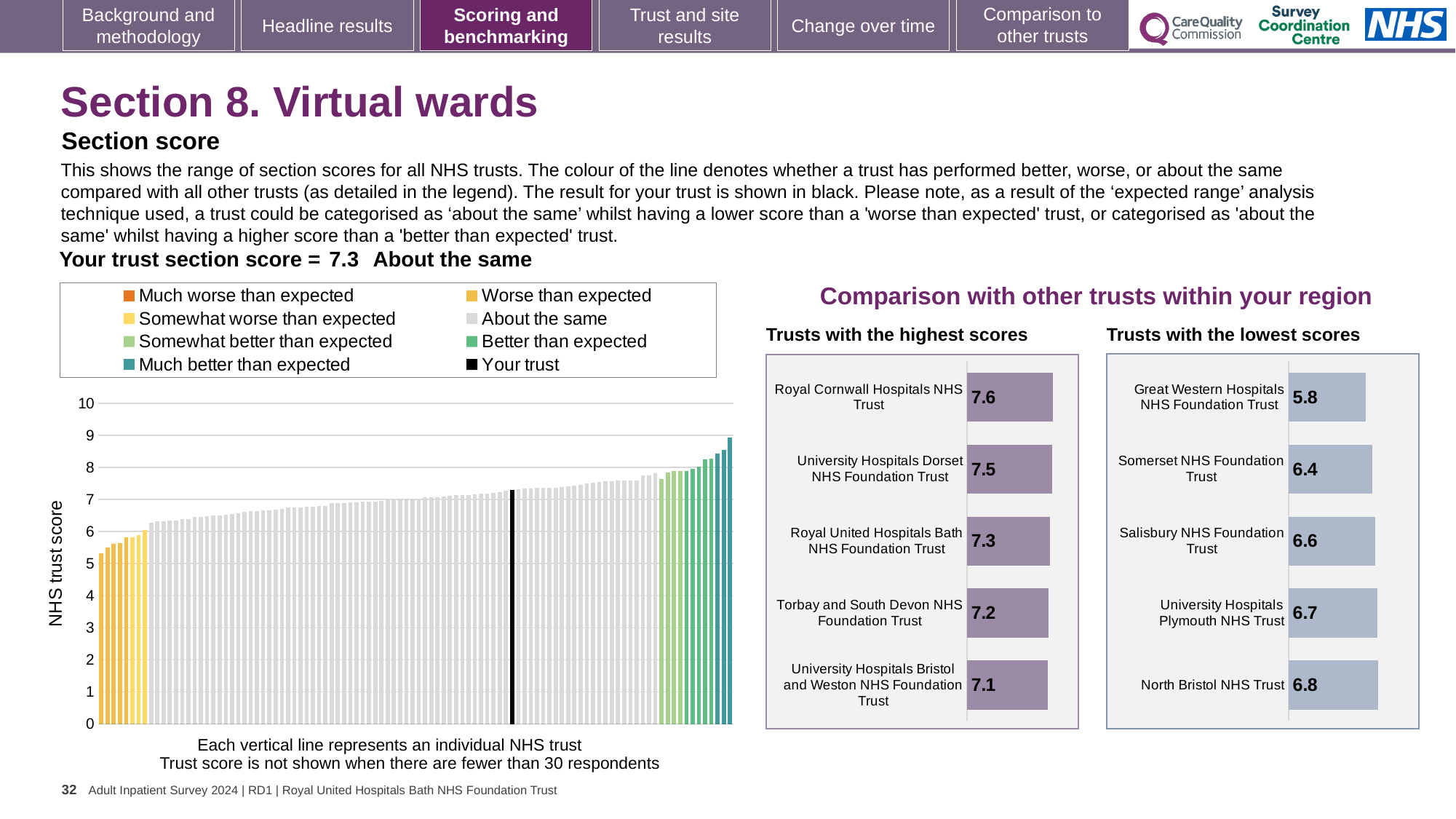
In the 'Trusts with the lowest scores' chart, what is the score for Somerset NHS Foundation Trust? 6.4 In the 'Trusts with the lowest scores' chart, how much higher is North Bristol NHS Trust's score than Great Western Hospitals NHS Foundation Trust's score? 1.0 In the 'Trusts with the highest scores' chart, which trust has the highest score? Royal Cornwall Hospitals NHS Trust In the 'Trusts with the highest scores' chart, what is the difference between the scores of Royal Cornwall Hospitals NHS Trust and University Hospitals Bristol and Weston NHS Foundation Trust? 0.5 In the 'Trusts with the lowest scores' chart, which trust has the lowest score? Great Western Hospitals NHS Foundation Trust How many trusts are shown in the 'Trusts with the highest scores' chart? 5 In the 'Trusts with the lowest scores' chart, what is the score for University Hospitals Plymouth NHS Trust? 6.7 In the large 'NHS trust score' chart on the left, do the bar values rise or fall from left to right? Rise How many entries does the legend above the large 'NHS trust score' chart list? 8 In the 'Trusts with the highest scores' chart, what is the score for Royal Cornwall Hospitals NHS Trust? 7.6 What kind of chart is the large 'NHS trust score' chart on the left of the slide? Bar chart Which has the higher score: Torbay and South Devon NHS Foundation Trust in the 'highest scores' chart or Salisbury NHS Foundation Trust in the 'lowest scores' chart? Torbay and South Devon NHS Foundation Trust